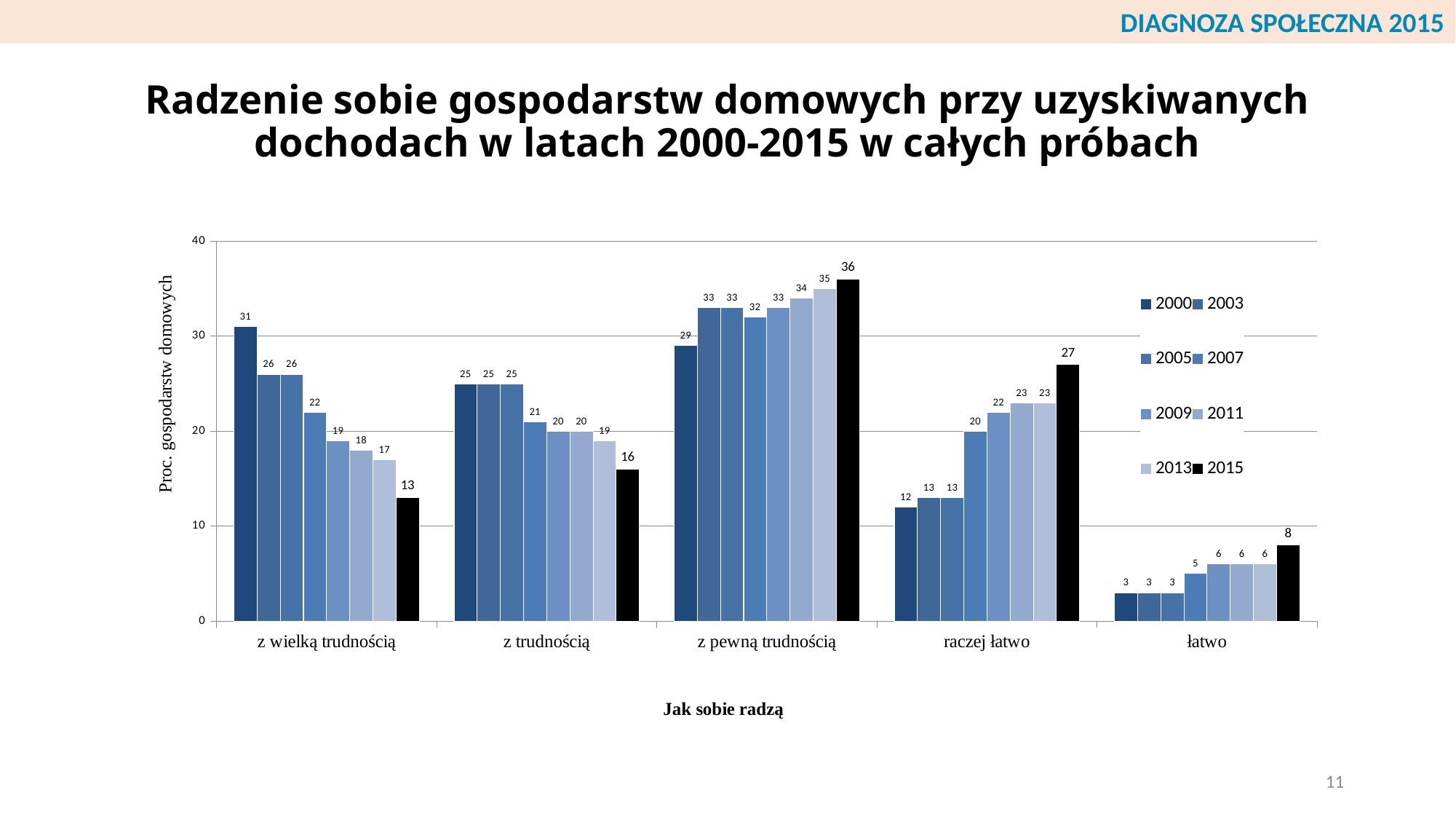
Which category has the highest value for 2015? z pewną trudnością What is the value for 2015 in the category 'raczej łatwo'? 27 Which is larger: the 2015 value for 'z trudnością' or the 2015 value for 'raczej łatwo'? raczej łatwo What is the difference between the 2000 and 2015 values in the category 'z wielką trudnością'? 18 What is the value for 2015 in the category 'z pewną trudnością'? 36 Do the values in the category 'raczej łatwo' rise or fall from 2000 to 2015? rise What is the value for 2000 in the category 'z wielką trudnością'? 31 What type of chart is shown on the slide? bar chart How many categories are shown on the x axis? 5 Which category has the lowest value for 2000? łatwo How many series does the legend list? 8 What is the label of the y axis? Proc. gospodarstw domowych